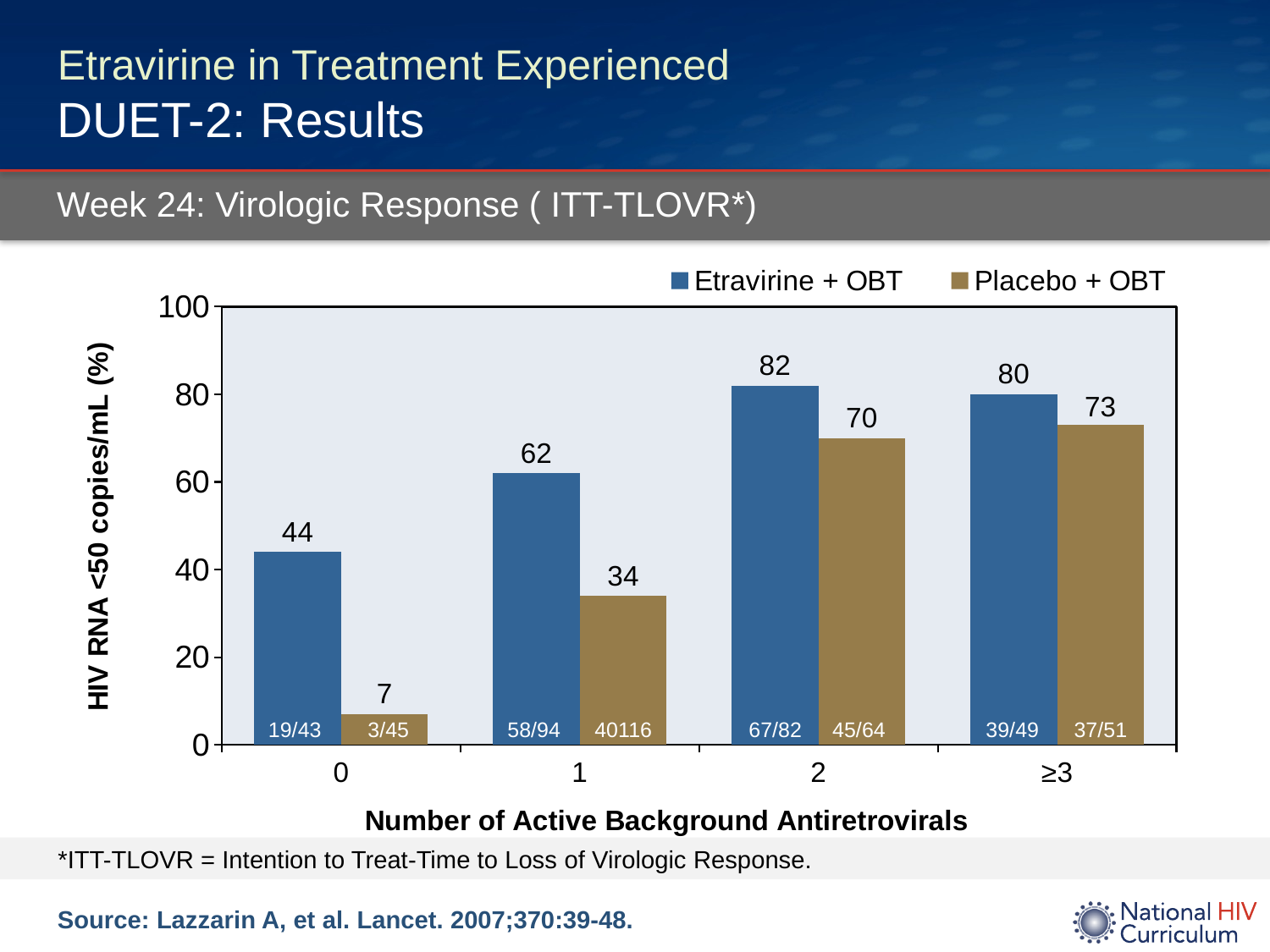
What is the label of the x axis? Number of Active Background Antiretrovirals Which category has the highest value for Etravirine + OBT? 2 What is the value for Etravirine + OBT at 0 active background antiretrovirals? 44 Which category has the lowest value for Placebo + OBT? 0 What is the value for Placebo + OBT at ≥3 active background antiretrovirals? 73 What is the value for Placebo + OBT at 1 active background antiretroviral? 34 Which is larger at 2 active background antiretrovirals: Etravirine + OBT or Placebo + OBT? Etravirine + OBT How many series does the legend list? 2 What is the difference between Etravirine + OBT and Placebo + OBT at 0 active background antiretrovirals? 37 What is the difference between Etravirine + OBT and Placebo + OBT at 1 active background antiretroviral? 28 What kind of chart is shown on the slide? Bar chart How many categories are shown on the x axis? 4